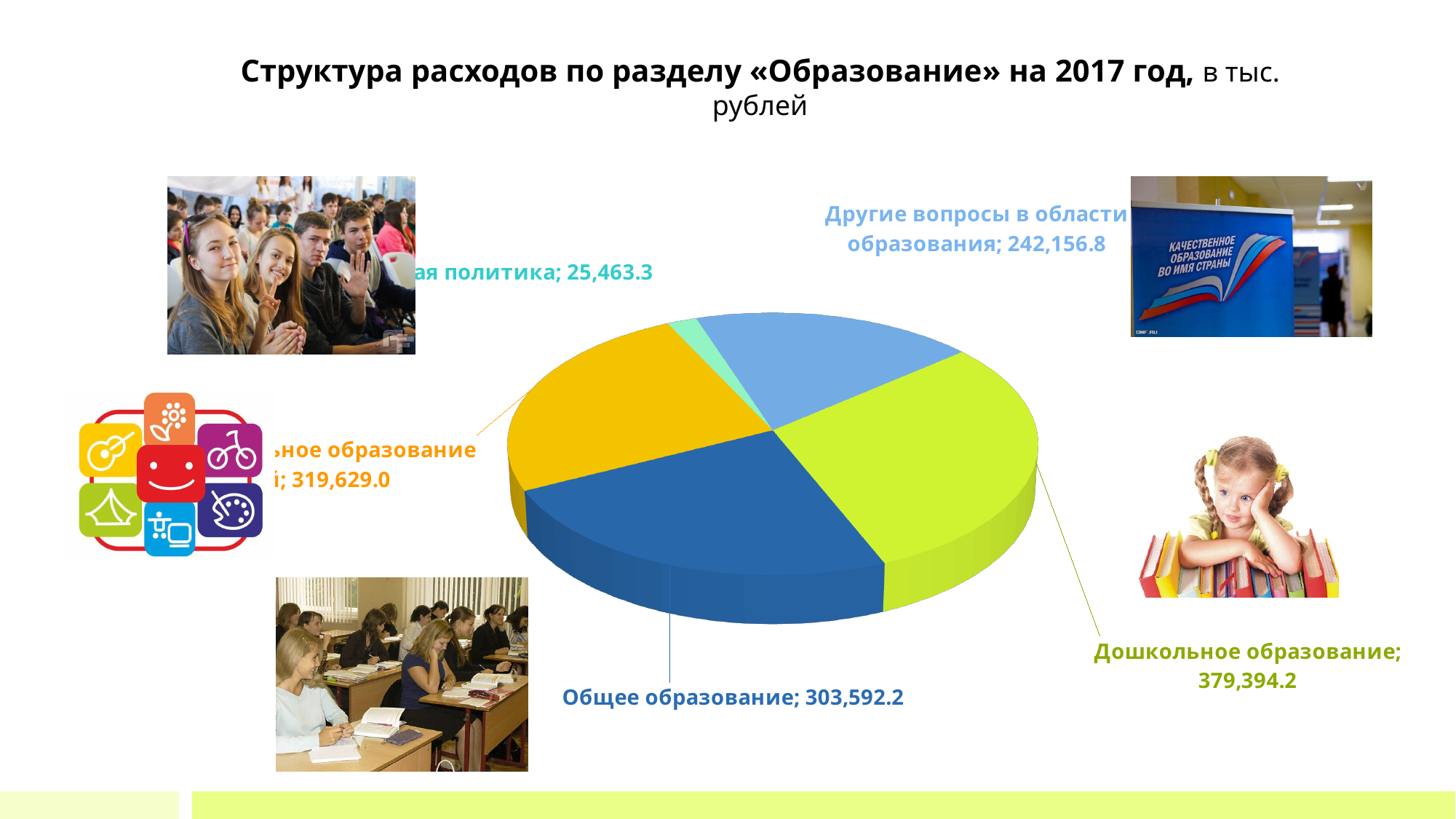
What is the value for Дошкольное образование? 379,394.2 What is the value for Общее образование? 303,592.2 Which is larger: Общее образование or Другие вопросы в области образования? Общее образование In what units are the values in the chart expressed, according to the title? тыс. рублей Which category has the largest value in the pie chart? Дошкольное образование What is the value of the smallest slice in the pie chart? 25,463.3 What kind of chart is shown on the slide? pie chart What is the difference between Общее образование and Другие вопросы в области образования? 61,435.4 What year does the chart title refer to? 2017 How many slices does the pie chart have? 5 What is the difference between Дошкольное образование and Общее образование? 75,802.0 What is the value for Другие вопросы в области образования? 242,156.8